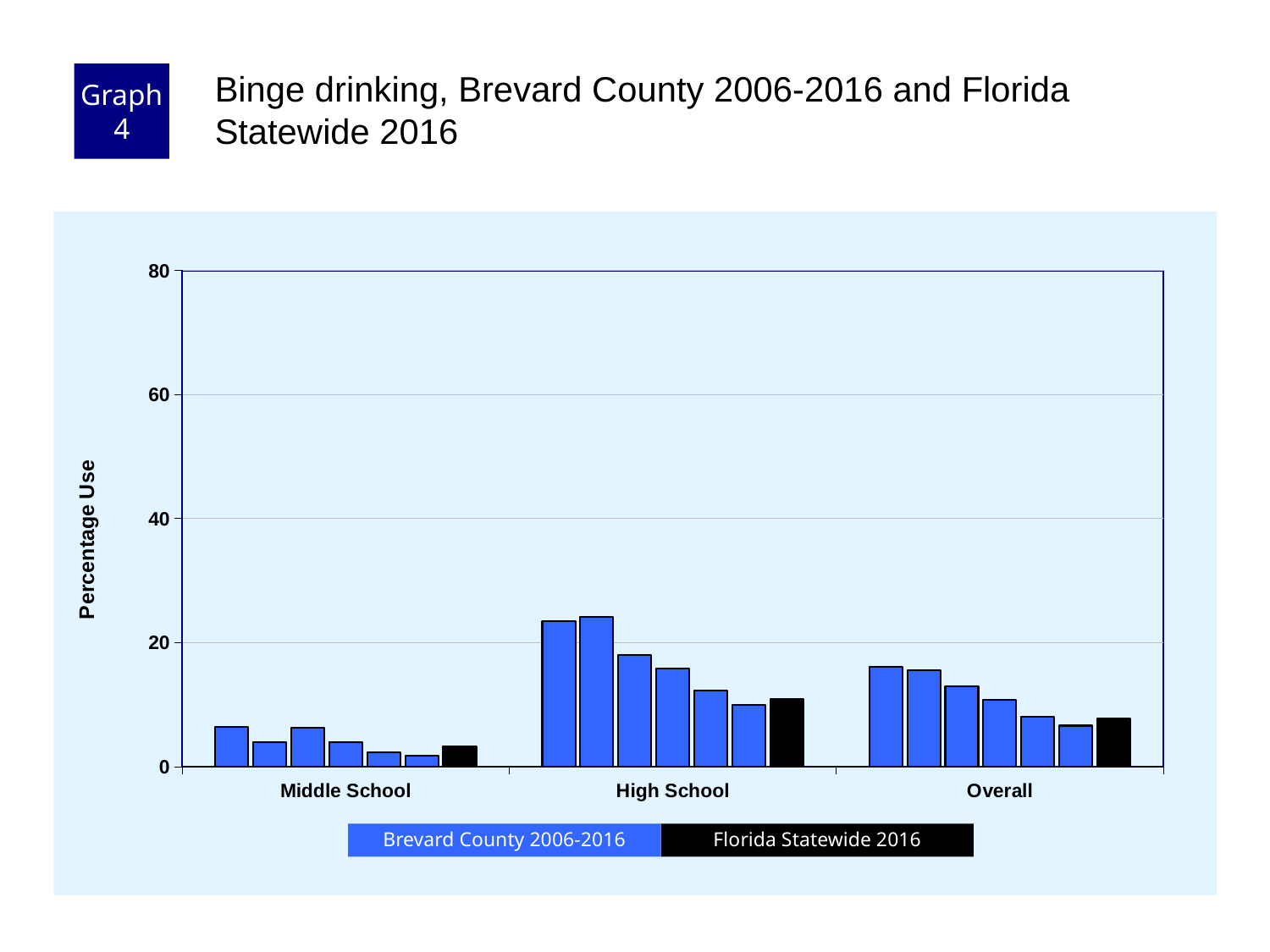
Which category has the tallest bars overall: Middle School, High School or Overall? High School How many categories are shown on the x axis of the chart? 3 Within the Overall group, do the Brevard County 2006-2016 bars rise or fall from left to right? fall Is the Florida Statewide 2016 value for High School greater or less than 20? less Is the Florida Statewide 2016 value for Middle School greater or less than 20? less What is the title of the chart? Binge drinking, Brevard County 2006-2016 and Florida Statewide 2016 What is the label on the vertical axis of the chart? Percentage Use How many series does the chart legend list? 2 Which is larger, the Florida Statewide 2016 value for High School or for Middle School? High School Which category has the lowest bars overall? Middle School Is the tallest Brevard County 2006-2016 bar in the High School group greater or less than 20? greater What kind of chart is shown on the slide? bar chart